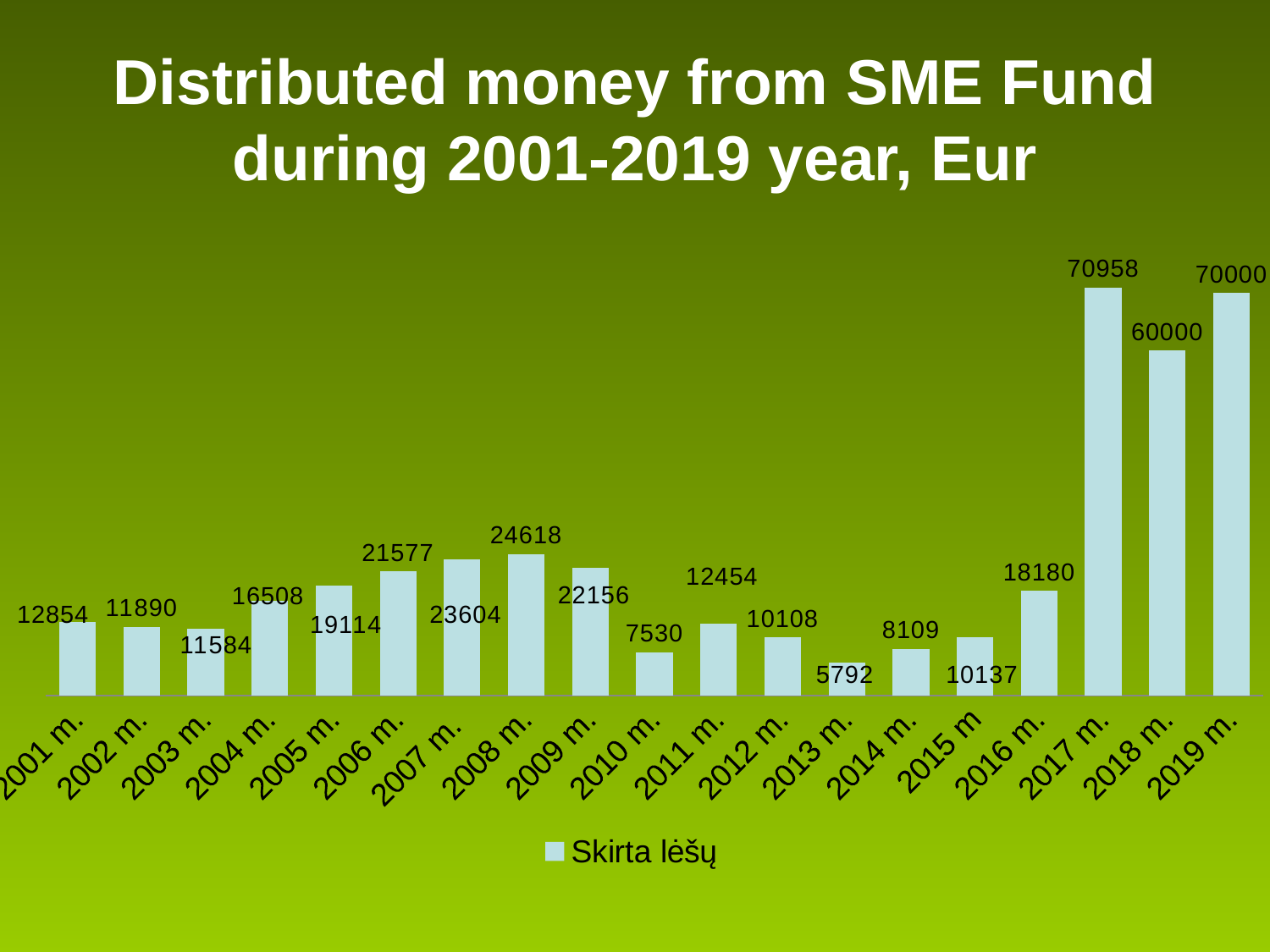
What is the value for 2013 m.? 5792 What is the difference between the values for 2017 m. and 2016 m.? 52778 What is the difference between the values for 2019 m. and 2018 m.? 10000 Which year has the lowest value? 2013 m. Which year has the highest value? 2017 m. What is the value for 2001 m.? 12854 How many series does the legend list? 1 What is the value for 2008 m.? 24618 What kind of chart is shown on the slide? Bar chart What is the value for 2017 m.? 70958 Which is larger, the value for 2009 m. or the value for 2011 m.? 2009 m. How many years are shown on the x axis? 19